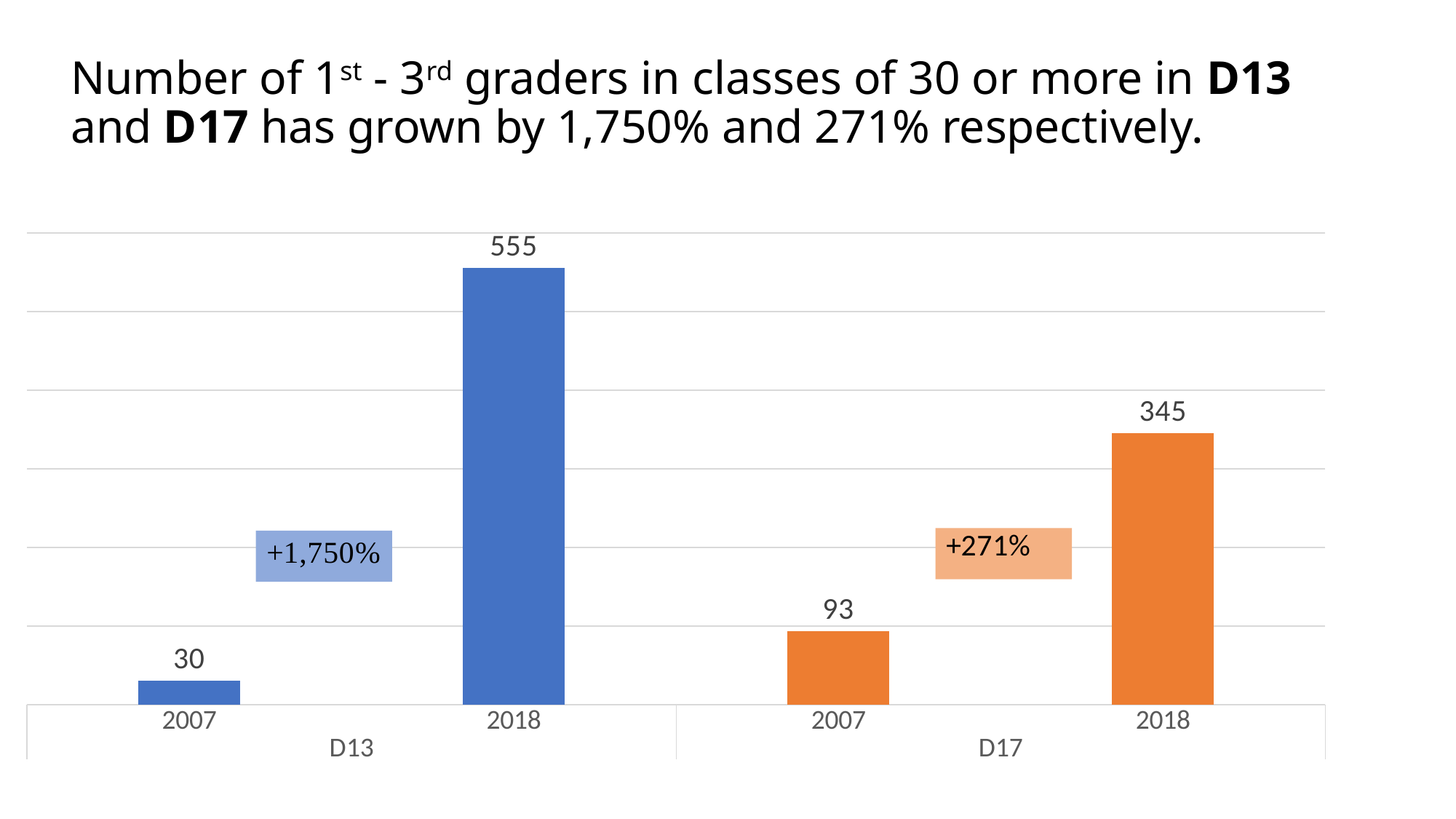
What is the value for D17 in 2007? 93 Which bar has the lowest value? D13 2007 What is the value for D13 in 2018? 555 What is the difference between the D17 values for 2018 and 2007? 252 What is the value for D13 in 2007? 30 What percentage growth is labelled for D17? +271% Which is larger, the 2018 value for D13 or the 2018 value for D17? D13 What is the difference between the D13 values for 2018 and 2007? 525 What is the value for D17 in 2018? 345 What kind of chart is shown? Bar chart Which bar has the highest value? D13 2018 How many bars are plotted on the chart? 4